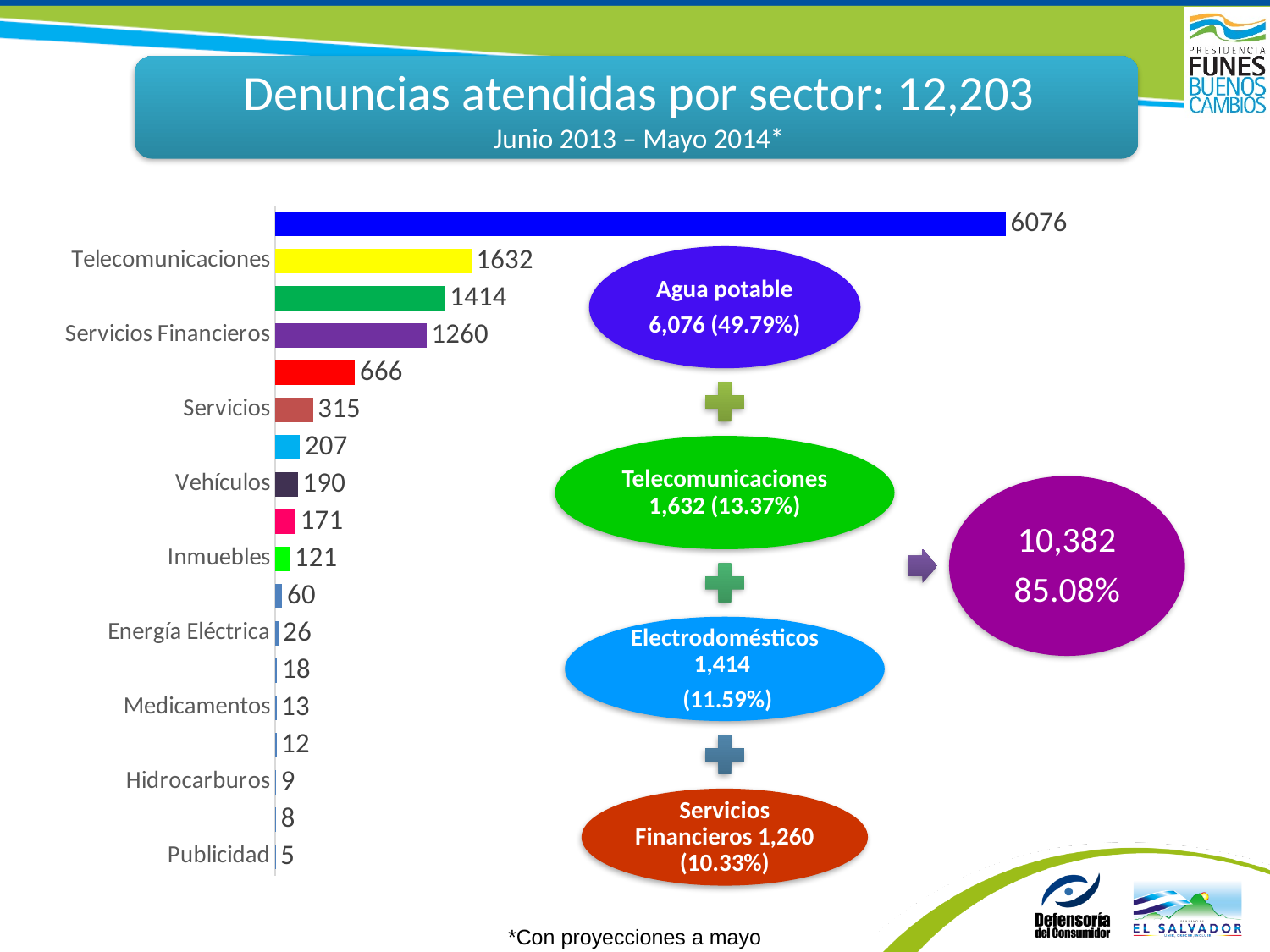
What kind of chart is shown on the slide? Bar chart Which is larger, the value for Vehículos or the value for Inmuebles? Vehículos What is the largest value shown on the chart? 6076 What is the value for Telecomunicaciones? 1632 What is the value for Servicios? 315 What is the value for Hidrocarburos? 9 What is the value for Servicios Financieros? 1260 What is the difference between the values for Telecomunicaciones and Servicios Financieros? 372 How many bars does the chart have? 18 What is the value for Vehículos? 190 Which labelled category has the lowest value? Publicidad What is the value for Energía Eléctrica? 26